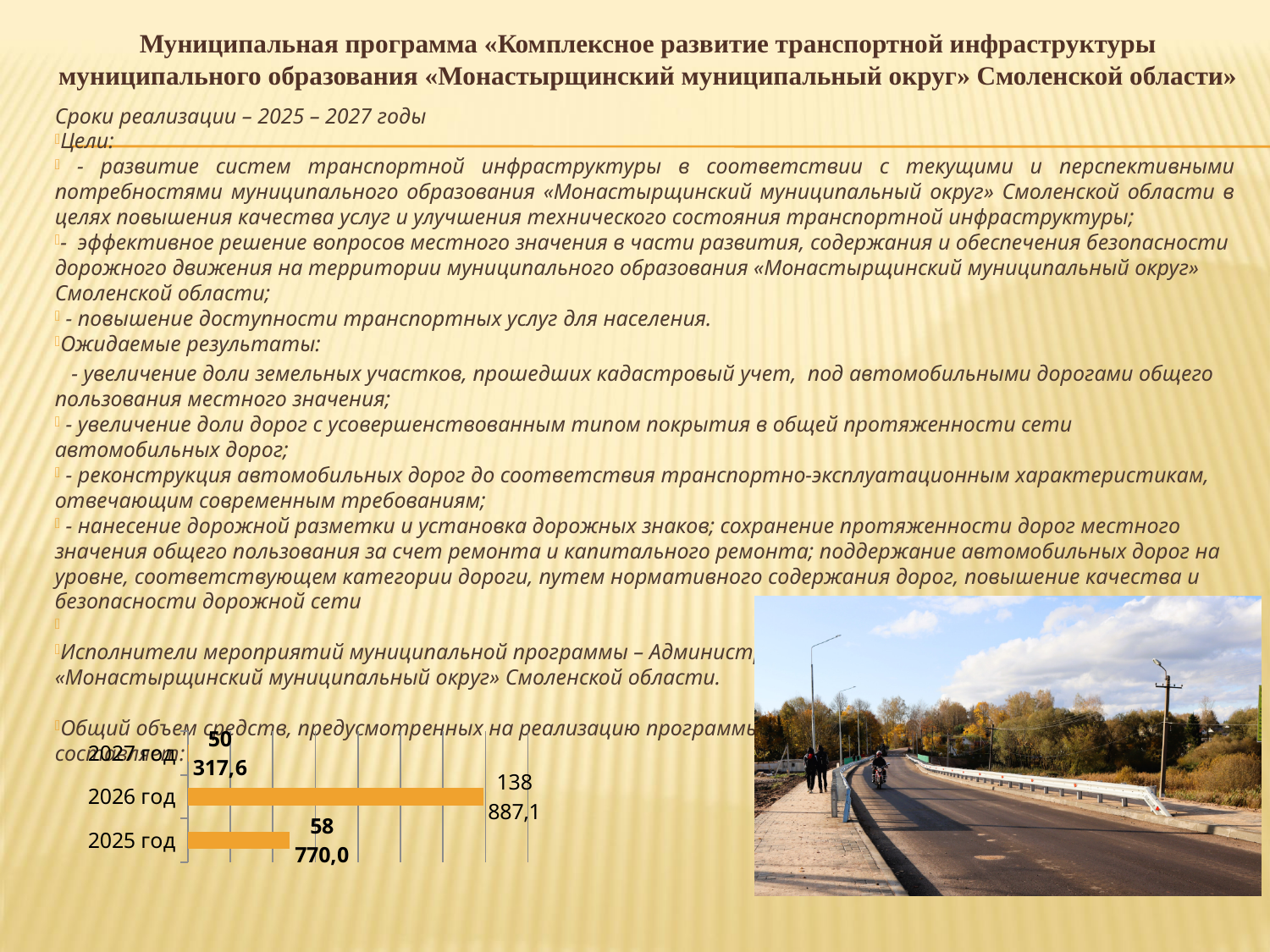
What is the difference between the values for 2025 год and 2027 год in the bar chart? 8 452,4 What colour are the bars in the bar chart? orange What is the value shown for 2026 год in the bar chart? 138 887,1 Which year has the highest value in the bar chart? 2026 год What is the value shown for 2027 год in the bar chart? 50 317,6 Which is larger in the bar chart, the value for 2025 год or the value for 2027 год? 2025 год What is the value shown for 2025 год in the bar chart? 58 770,0 Which is larger in the bar chart, the value for 2026 год or the value for 2025 год? 2026 год What is the difference between the values for 2026 год and 2025 год in the bar chart? 80 117,1 Which year has the lowest value in the bar chart? 2027 год What kind of chart is shown at the bottom left of the slide? bar chart How many categories (years) does the bar chart show? 3